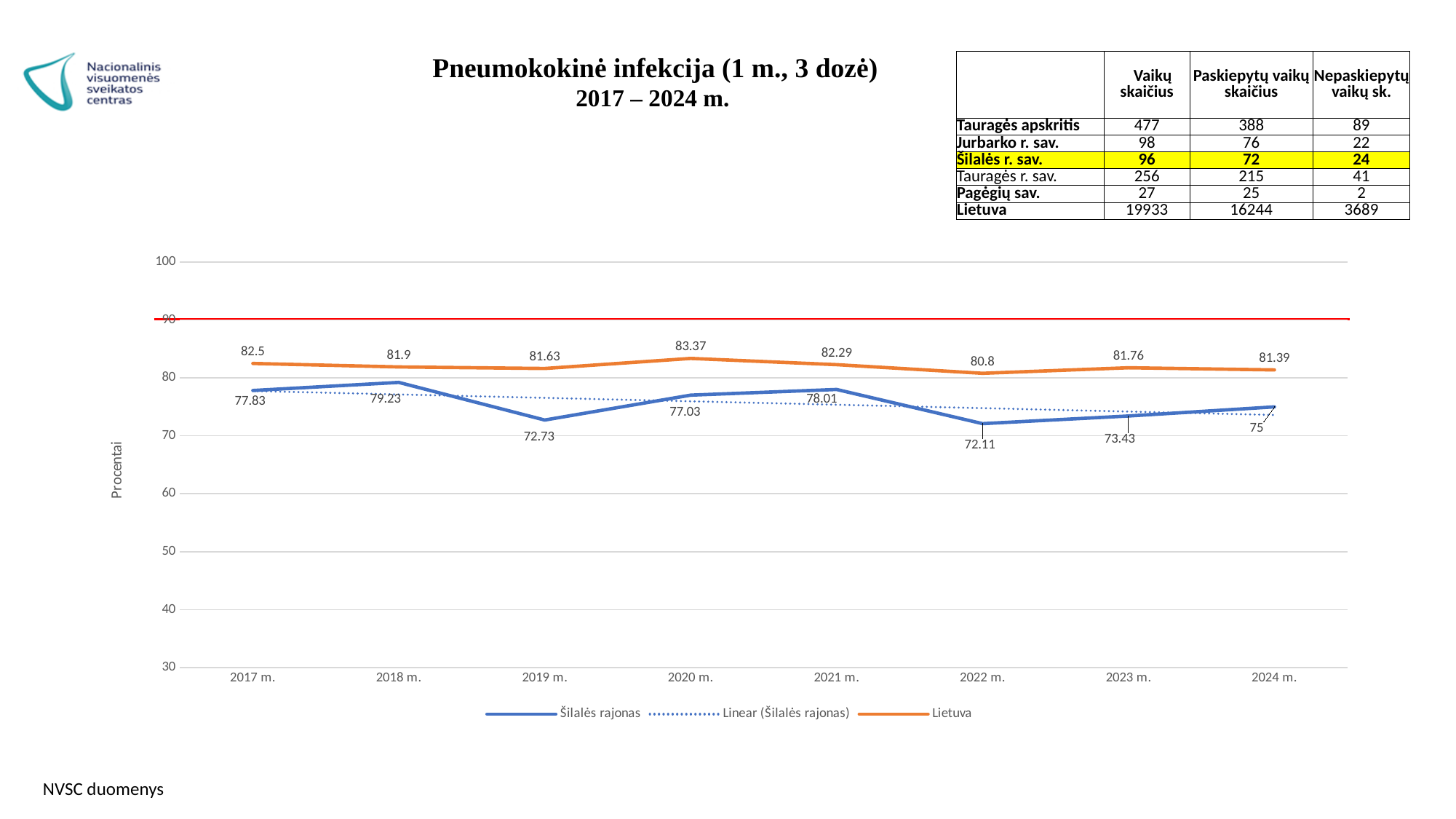
In which year does the Šilalės rajonas series have its lowest value? 2022 m. Which is larger in 2018 m., the value for Šilalės rajonas or for Lietuva? Lietuva What is the label of the vertical axis of the chart? Procentai Is the value for Šilalės rajonas in 2021 m. greater or less than 80? less What is the value for Šilalės rajonas in 2019 m.? 72.73 How many entries does the chart legend list? 3 In which year does the Lietuva series reach its highest value? 2020 m. What is the value for Šilalės rajonas in 2024 m.? 75 What is the difference between the Lietuva and Šilalės rajonas values in 2022 m.? 8.69 What type of chart is shown on the slide? line chart What is the value for Lietuva in 2020 m.? 83.37 How many years are shown on the x axis of the chart? 8